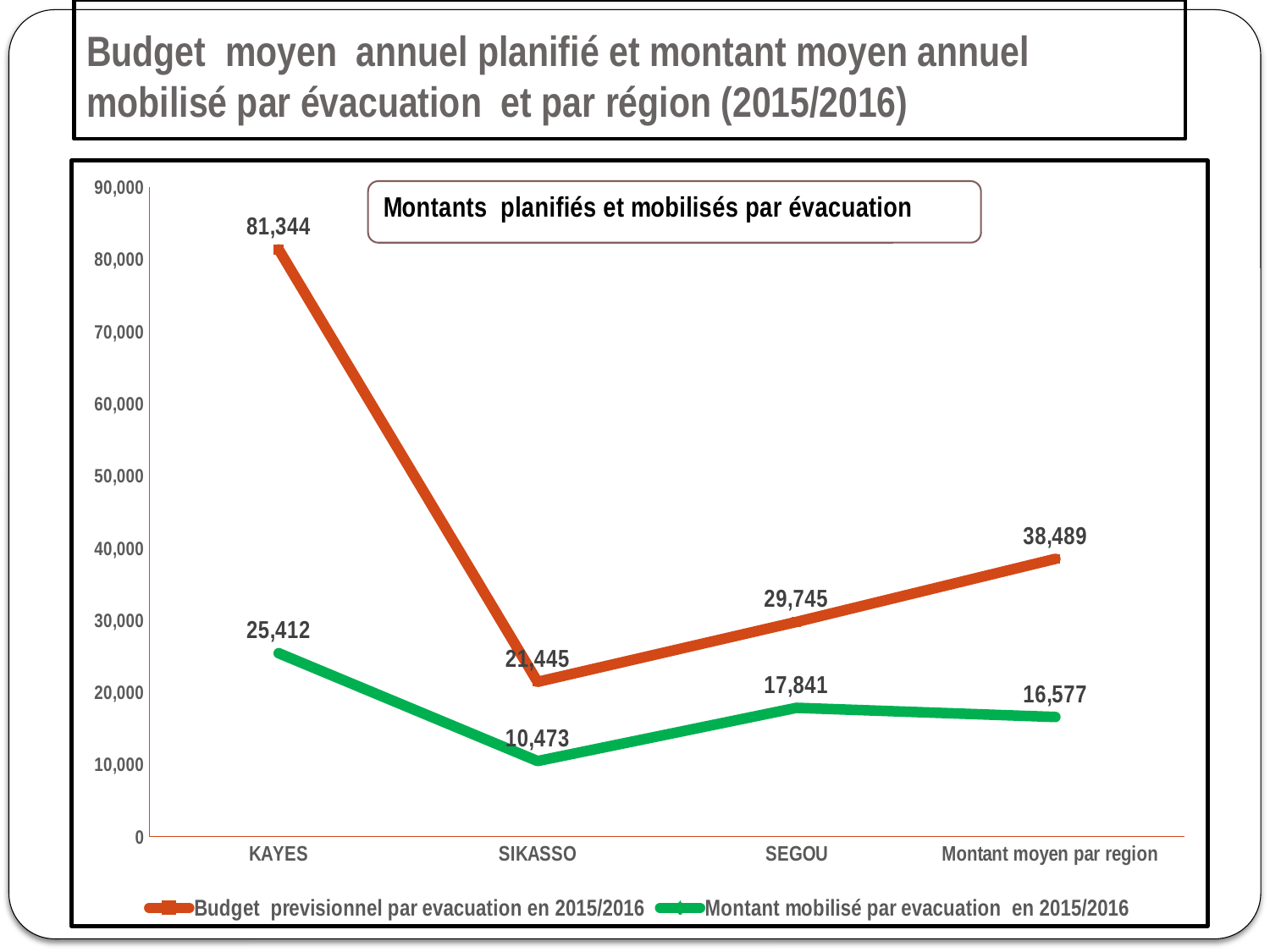
What is the Budget previsionnel par evacuation en 2015/2016 for KAYES? 81,344 What is the difference between the Budget previsionnel and the Montant mobilisé for KAYES? 55,932 Which is larger for SEGOU: the Budget previsionnel par evacuation or the Montant mobilisé par evacuation? Budget previsionnel par evacuation en 2015/2016 How many series does the legend list? 2 What is the Montant mobilisé par evacuation en 2015/2016 for SIKASSO? 10,473 What is the Budget previsionnel par evacuation en 2015/2016 for SEGOU? 29,745 Which category has the lowest Montant mobilisé par evacuation en 2015/2016? SIKASSO What is the Montant mobilisé par evacuation en 2015/2016 for Montant moyen par region? 16,577 How many categories are shown on the x axis? 4 Which category has the highest Budget previsionnel par evacuation en 2015/2016? KAYES What type of chart is shown on the slide? line chart What is the title shown inside the chart area? Montants planifiés et mobilisés par évacuation